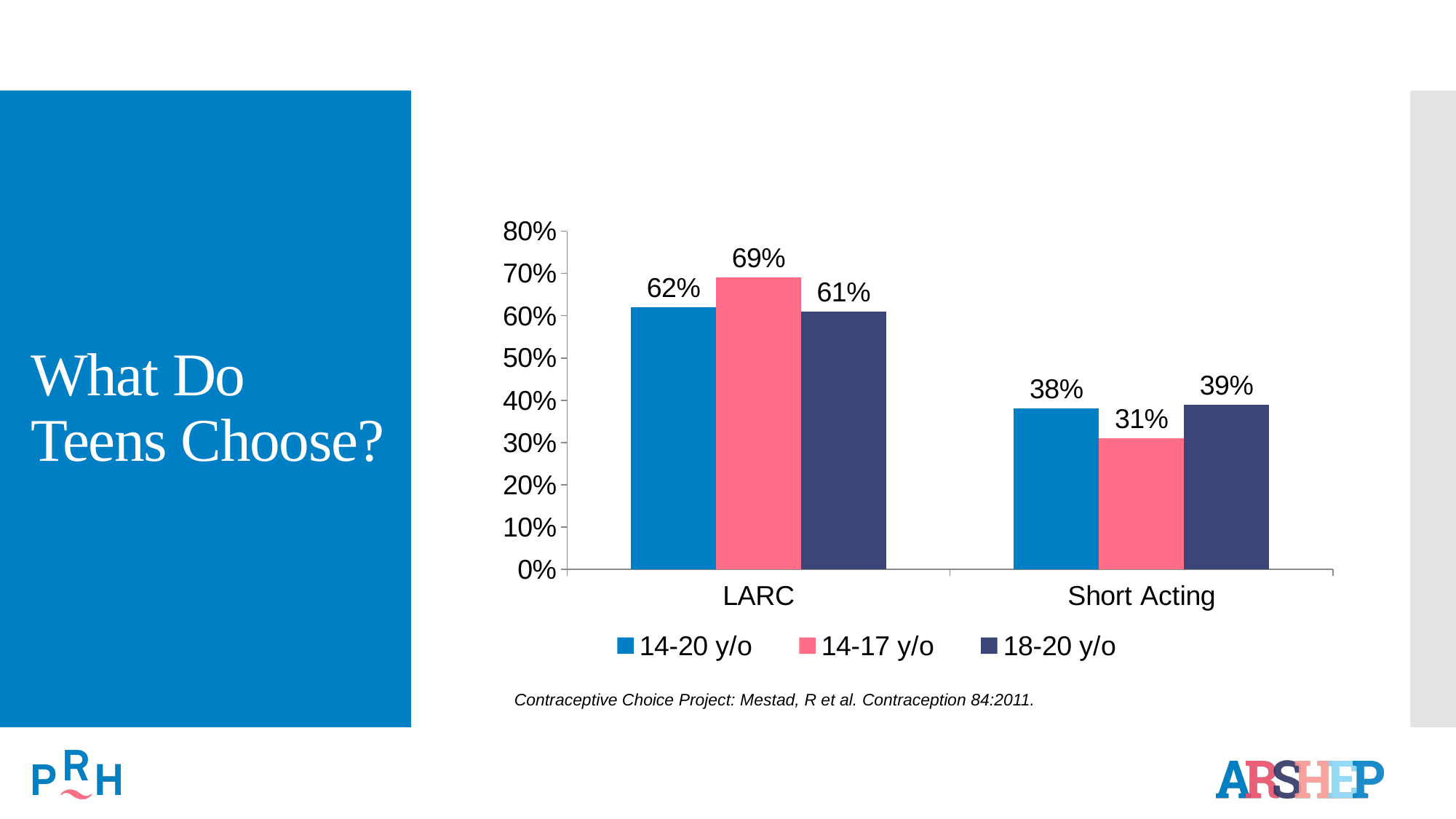
How many series does the legend list? 3 What is the value for 18-20 y/o in the Short Acting category? 39% What is the difference between the 14-17 y/o values for LARC and Short Acting? 38% How many categories are shown on the x axis? 2 What percentage of 14-17 y/o chose LARC? 69% Which colour represents the 14-17 y/o series in the legend? Pink Which age group has the highest value for LARC? 14-17 y/o What is the difference between the 14-20 y/o and 18-20 y/o values for LARC? 1% Which is larger for 18-20 y/o: LARC or Short Acting? LARC What kind of chart is shown on the slide? Bar chart Which age group has the lowest value for Short Acting? 14-17 y/o What percentage of 14-20 y/o chose Short Acting methods? 38%